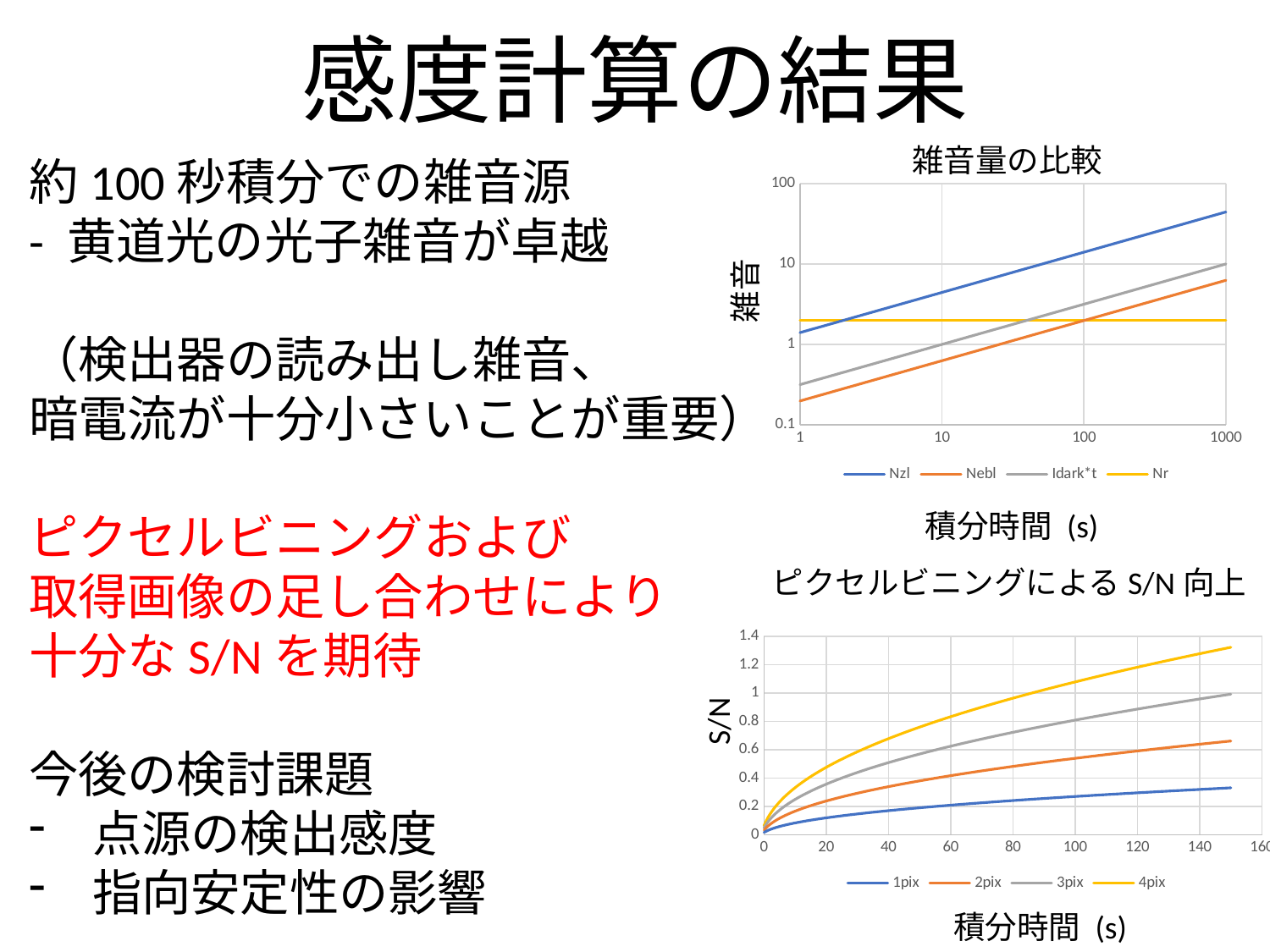
In the chart titled ピクセルビニングによるS/N向上, how many series does the legend list? 4 In the chart titled 雑音量の比較, does the Nr series rise, fall, or stay flat as integration time increases? stays flat In the chart titled 雑音量の比較, which series has the highest value at an integration time of 1000 s? Nzl In the chart titled ピクセルビニングによるS/N向上, is the S/N of 4pix at 150 s greater or less than 1.2? greater In the chart titled 雑音量の比較, how many series does the legend list? 4 In the chart titled ピクセルビニングによるS/N向上, which series has the highest S/N at 150 s? 4pix What kind of chart is the chart titled 雑音量の比較? line chart In the chart titled ピクセルビニングによるS/N向上, which series has the lowest S/N at 150 s? 1pix In the chart titled ピクセルビニングによるS/N向上, is the S/N of 1pix at 150 s greater or less than 0.4? less In the chart titled 雑音量の比較, at 1000 s, which is larger: Nzl or Nebl? Nzl In the chart titled 雑音量の比較, is the value of Nebl at 1 s greater or less than 1? less